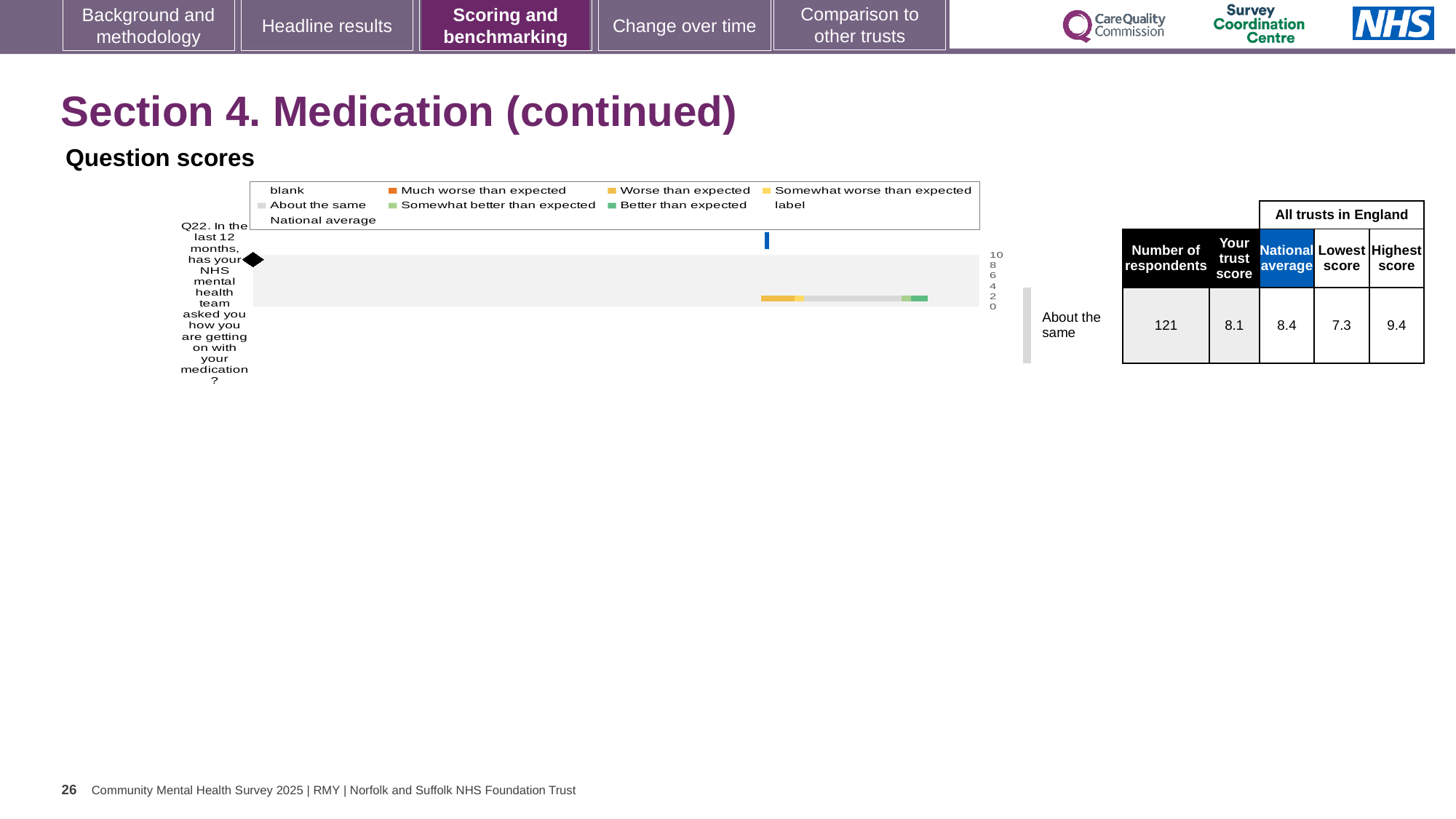
What is the trust's score for Q22 (asked how you are getting on with your medication)? 8.1 What is the national average score for Q22? 8.4 Which legend entry is shown in orange? Much worse than expected What is the lowest score among all trusts in England for Q22? 7.3 What kind of chart is used to show the Q22 question score? bar chart What is the highest score among all trusts in England for Q22? 9.4 How is the trust's Q22 result categorised relative to what was expected? About the same How many survey questions are plotted on the chart? 1 How many respondents answered Q22? 121 How many entries does the chart legend list? 9 What is the difference between the highest and lowest trust scores in England for Q22? 2.1 Which is larger for Q22: the trust's score or the national average? National average